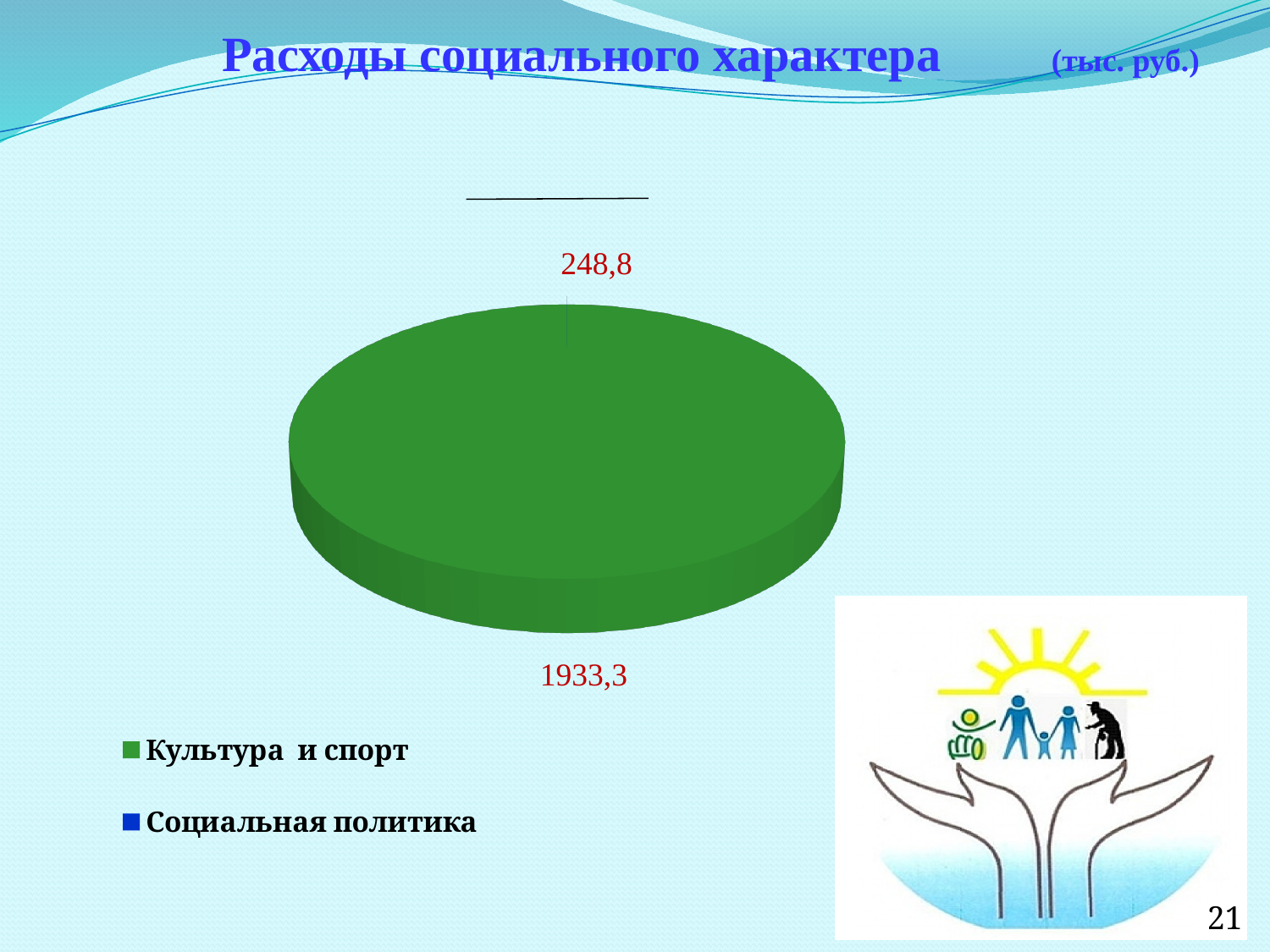
What value is shown for Социальная политика on the pie chart? 248,8 Which category takes up the smallest share of the pie chart? Социальная политика What kind of chart is shown on the slide? pie chart In what units are the values on the chart given, according to the slide? тыс. руб. What is the title of the chart on the slide? Расходы социального характера What is the total of the two values shown on the pie chart? 2182,1 What value is shown for Культура и спорт on the pie chart? 1933,3 What colour represents Культура и спорт in the legend? green Which is larger on the pie chart: Культура и спорт or Социальная политика? Культура и спорт Which category takes up the largest share of the pie chart? Культура и спорт What is the difference between the two values shown on the pie chart, 1933,3 and 248,8? 1684,5 How many categories does the legend of the pie chart list? 2